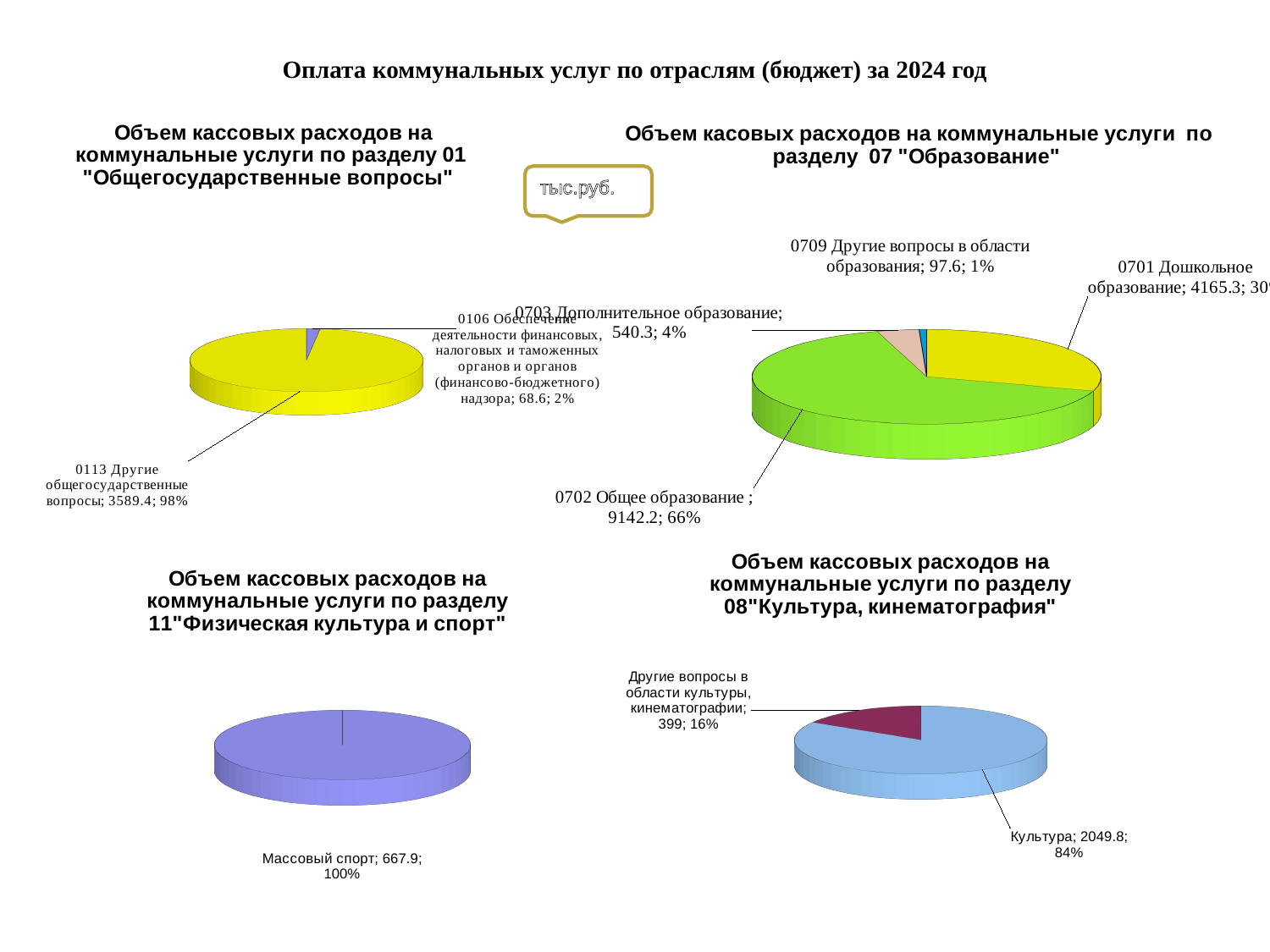
In the pie chart for раздел 01 "Общегосударственные вопросы", what is the value for 0113 Другие общегосударственные вопросы? 3589.4 In the pie chart for раздел 07 "Образование", what is the difference between the values for 0701 Дошкольное образование and 0703 Дополнительное образование? 3625.0 In the pie chart for раздел 11 "Физическая культура и спорт", what is the value for Массовый спорт? 667.9 In the pie chart for раздел 07 "Образование", what share of the pie does 0703 Дополнительное образование have? 4% In the pie chart for раздел 08 "Культура, кинематография", what is the value for Культура? 2049.8 In the pie chart for раздел 07 "Образование", which category has the largest value? 0702 Общее образование In the pie chart for раздел 08 "Культура, кинематография", which is larger: Культура or Другие вопросы в области культуры, кинематографии? Культура In the pie chart for раздел 07 "Образование", what is the value for 0702 Общее образование? 9142.2 In the pie chart for раздел 01 "Общегосударственные вопросы", what share of the pie does the 0106 slice have? 2% In the pie chart for раздел 07 "Образование", which category has the smallest value? 0709 Другие вопросы в области образования What type of chart is used for раздел 11 "Физическая культура и спорт"? Pie chart In the pie chart for раздел 07 "Образование", how many slices are there? 4